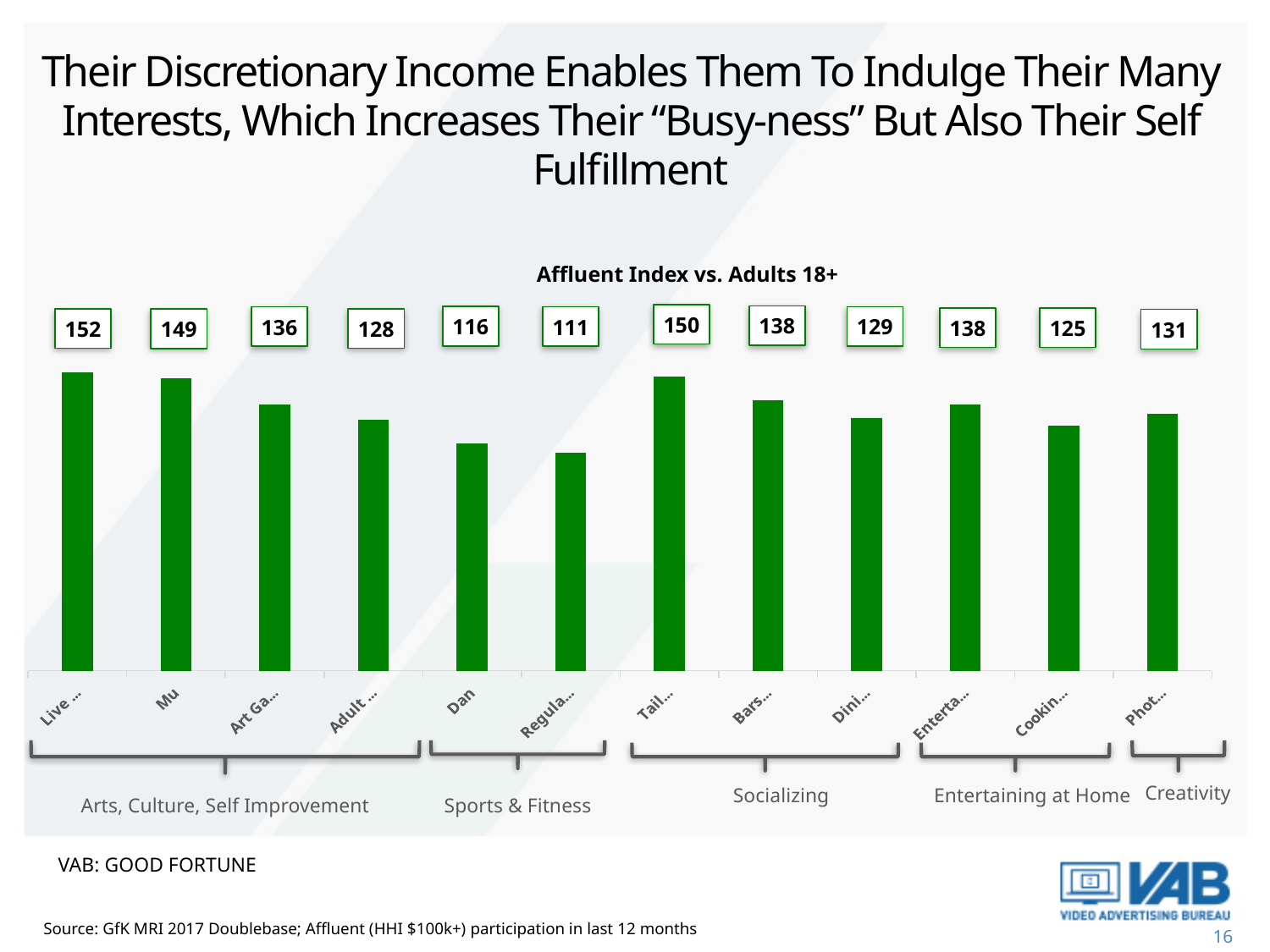
What is the highest value shown in the chart? 152 What is the lowest value shown in the chart? 111 How many bracketed groups are labelled beneath the bars? 5 How many bars are plotted in the chart? 12 Which is larger: the first bar in the Arts, Culture, Self Improvement group or the first bar in the Socializing group? the first bar in the Arts, Culture, Self Improvement group What is the value of the second bar in the Sports & Fitness group? 111 What kind of chart is shown on the slide? bar chart What is the title of the chart? Affluent Index vs. Adults 18+ What is the difference between the highest and lowest values in the chart? 41 Do the values rise or fall from left to right across the four bars in the Arts, Culture, Self Improvement group? fall What is the value of the first bar in the Socializing group? 150 What is the value of the single bar in the Creativity group? 131